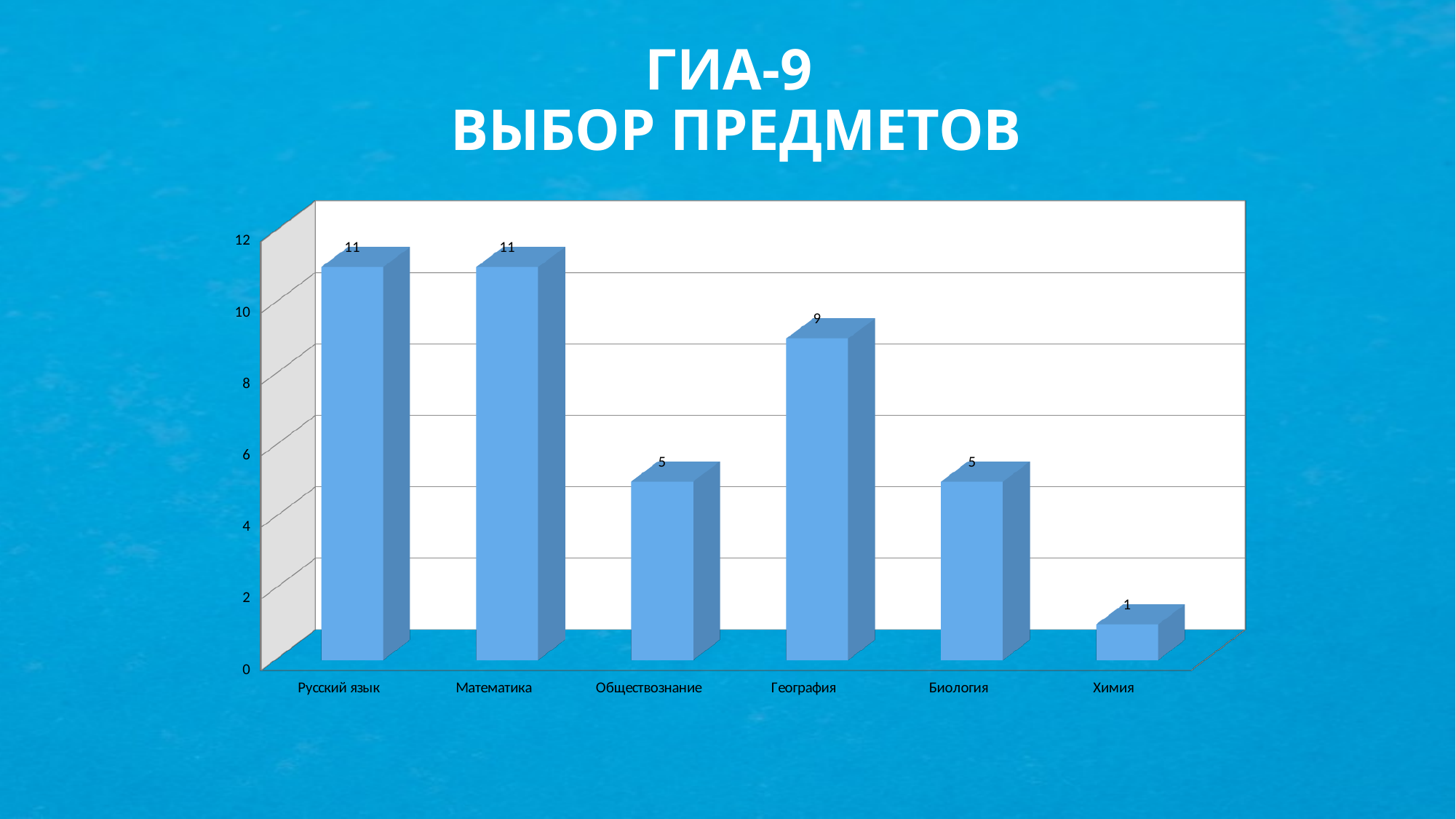
What is the value for Русский язык? 11 What is the value for Обществознание? 5 Which category has the lowest value? Химия What is the difference between the values for Биология and Химия? 4 Is the value for География greater or less than 8? greater What is the value for География? 9 What is the value for Химия? 1 What kind of chart is shown on the slide? bar chart What is the title of the slide? ГИА-9 ВЫБОР ПРЕДМЕТОВ How many categories are shown on the x axis? 6 Which is larger, the value for География or the value for Биология? География What is the difference between the values for Математика and География? 2